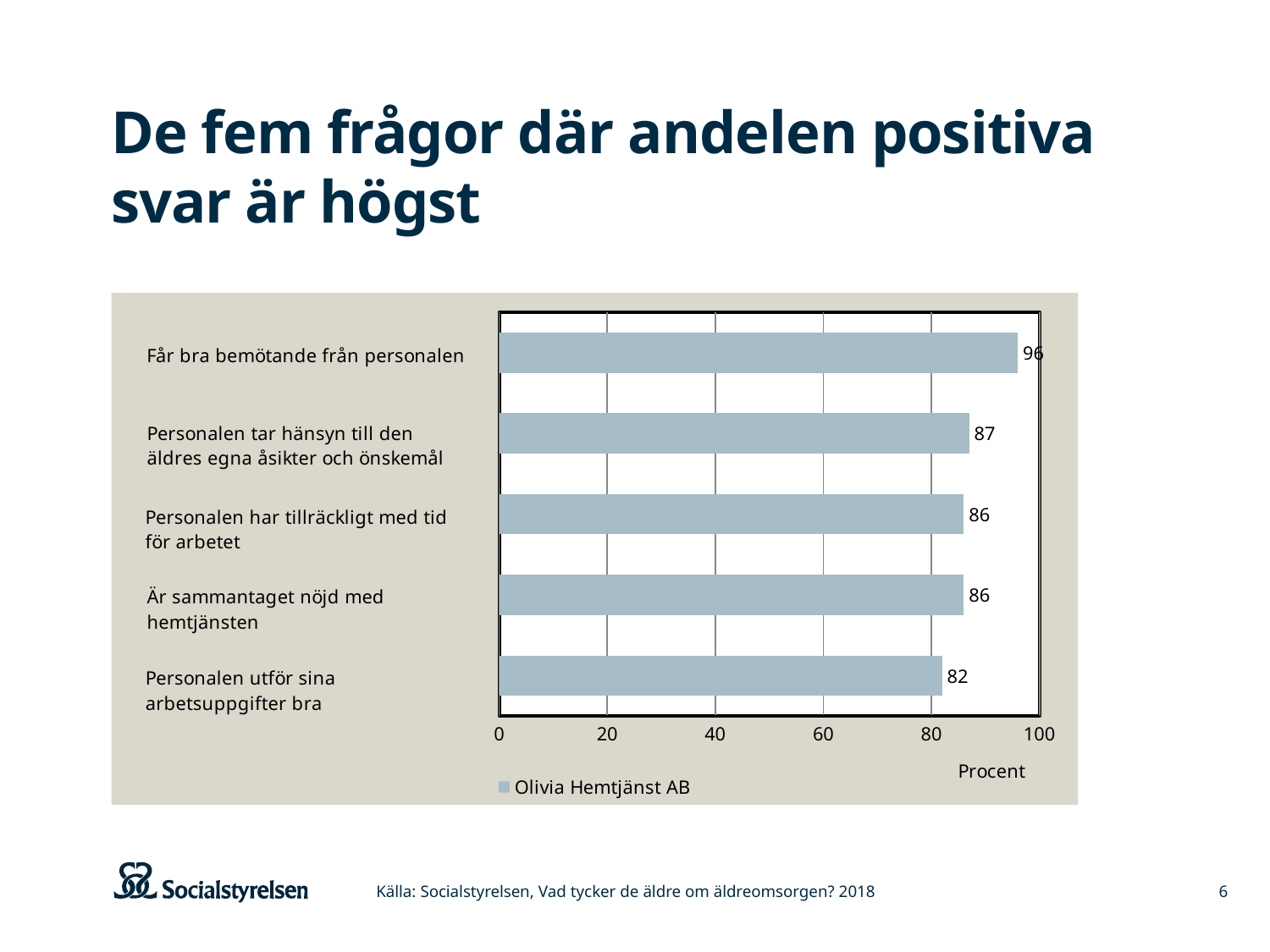
How many series does the legend list? 1 What is the value for "Får bra bemötande från personalen"? 96 What is the difference between the values for "Får bra bemötande från personalen" and "Personalen utför sina arbetsuppgifter bra"? 14 What series name is shown in the legend? Olivia Hemtjänst AB Is the value for "Är sammantaget nöjd med hemtjänsten" greater or less than 80? greater What is the value for "Personalen tar hänsyn till den äldres egna åsikter och önskemål"? 87 Which category has the lowest value? Personalen utför sina arbetsuppgifter bra Which category has the highest value? Får bra bemötande från personalen What is the value for "Personalen utför sina arbetsuppgifter bra"? 82 How many categories are shown in the chart? 5 Which is larger: the value for "Personalen tar hänsyn till den äldres egna åsikter och önskemål" or the value for "Personalen utför sina arbetsuppgifter bra"? Personalen tar hänsyn till den äldres egna åsikter och önskemål What kind of chart is shown on the slide? bar chart